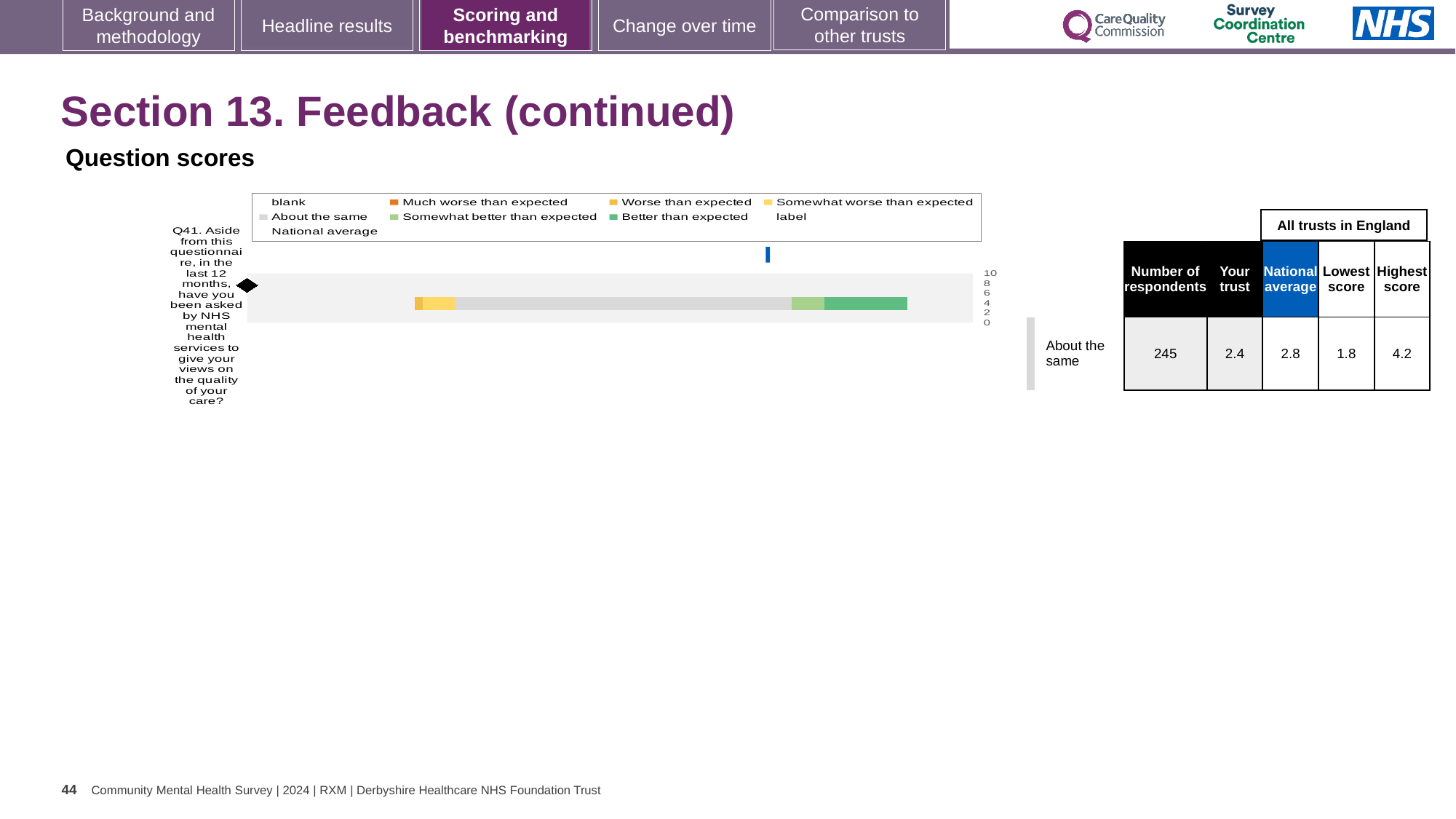
What kind of chart is used to show the Q41 question score? bar chart Which is larger for Q41, the trust's score or the national average? National average What colour does the legend use for 'Better than expected'? Green What is the highest score among all trusts in England for Q41? 4.2 What is the lowest score among all trusts in England for Q41? 1.8 What is the 'Your trust' score for Q41? 2.4 By how much does the national average exceed the trust's score for Q41? 0.4 Which benchmarking category does the trust's Q41 score fall into? About the same How many respondents answered Q41? 245 What is the difference between the highest and lowest trust scores for Q41? 2.4 How many survey questions are plotted on the chart? 1 What is the national average score for Q41? 2.8